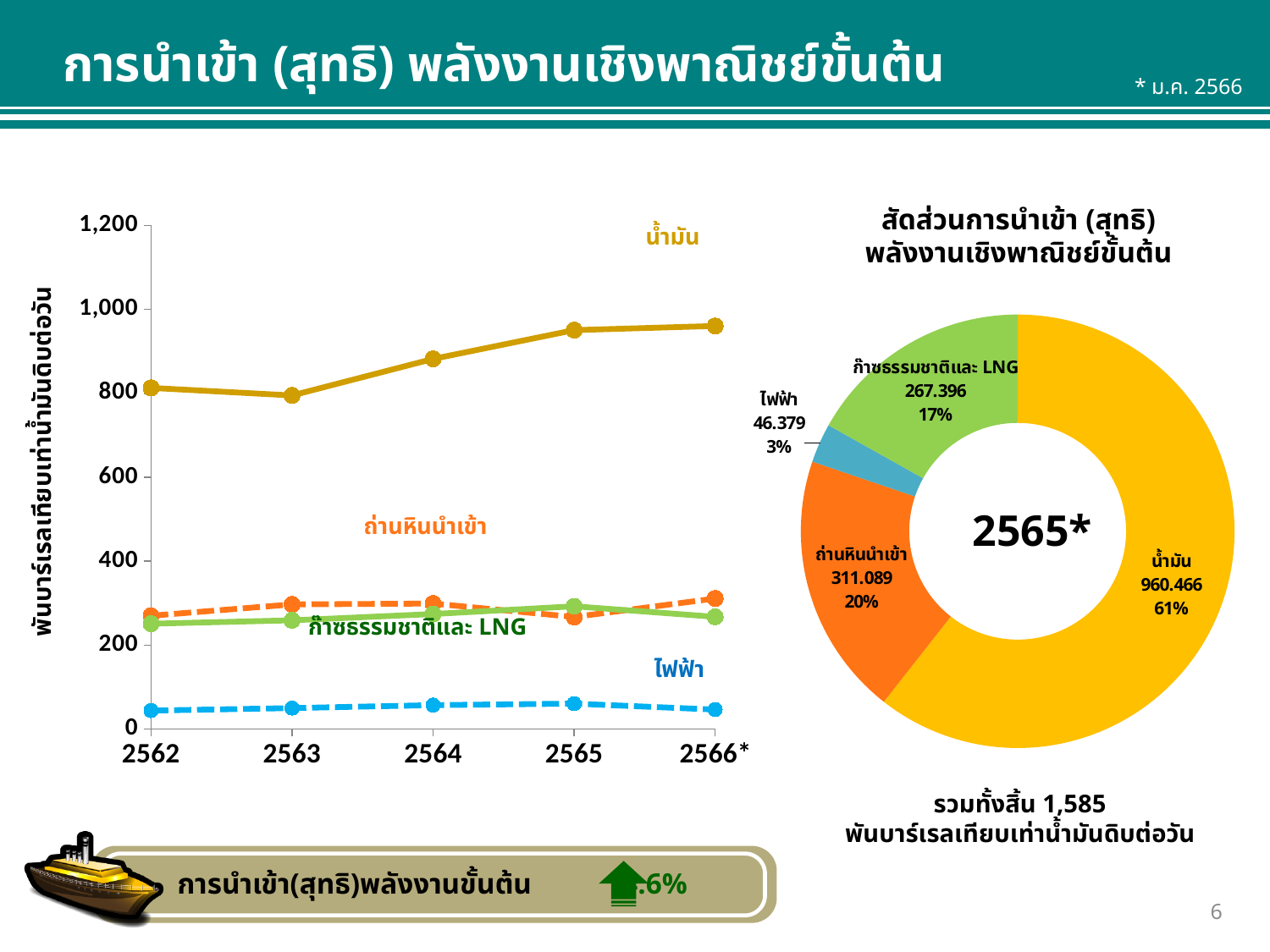
In the donut chart on the right, which category has the largest slice? น้ำมัน In the donut chart on the right, what is the value shown for น้ำมัน? 960.466 In the line chart on the left, how many years are shown on the x axis? 5 In the donut chart on the right, what share of the total does ถ่านหินนำเข้า account for? 20% In the donut chart on the right, what is the value shown for ก๊าซธรรมชาติและ LNG? 267.396 In the line chart on the left, does the น้ำมัน line rise or fall from 2563 to 2566*? rises In the donut chart on the right, what is the difference between the values for น้ำมัน and ถ่านหินนำเข้า? 649.377 How many slices does the donut chart on the right have? 4 In the line chart on the left, which is larger in 2565: ถ่านหินนำเข้า or ไฟฟ้า? ถ่านหินนำเข้า In the line chart on the left, is the value for น้ำมัน in 2566* greater or less than 800? greater In the donut chart on the right, which category has the smallest slice? ไฟฟ้า What kind of chart is the chart on the left side of the slide? Line chart